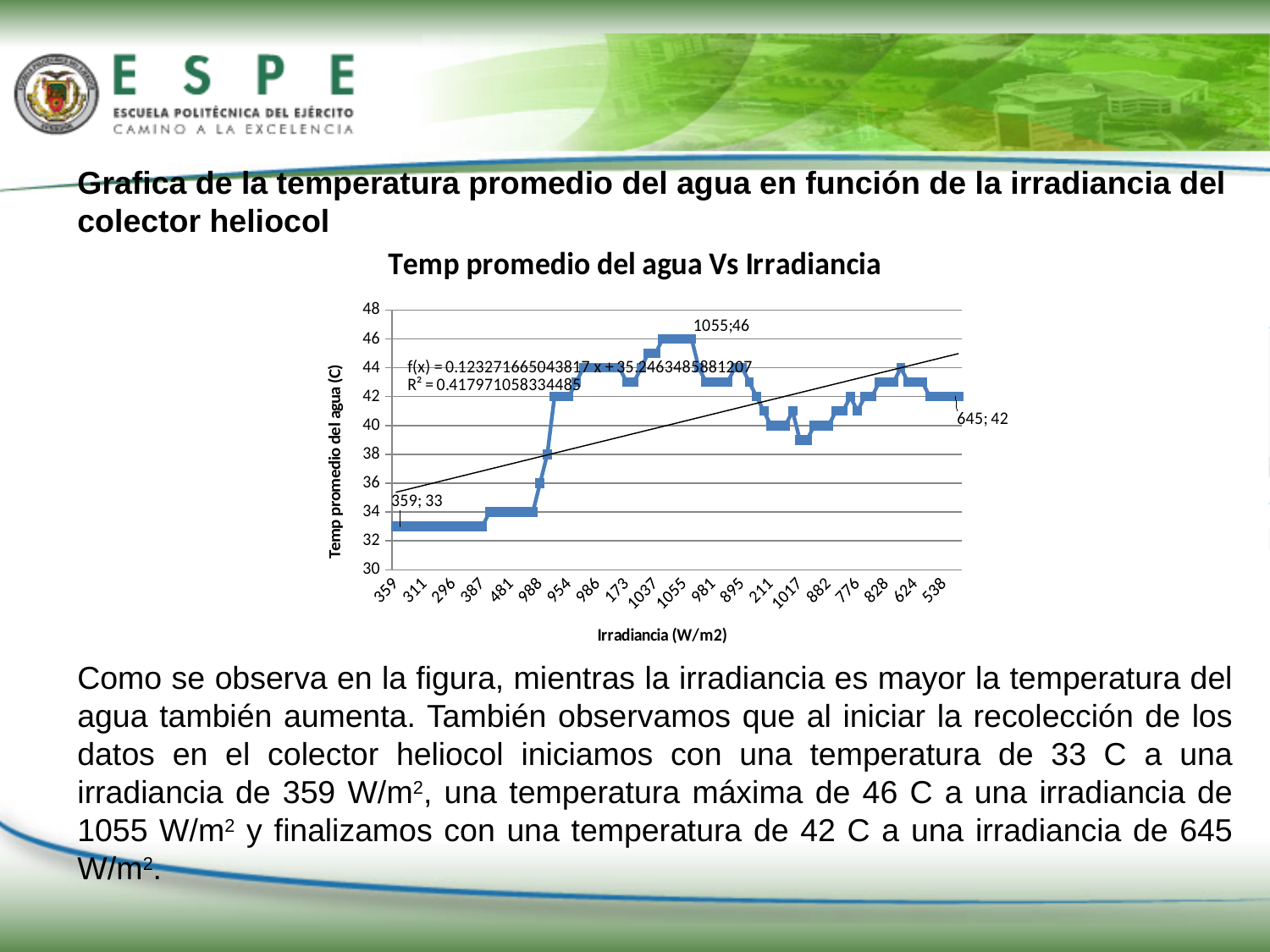
What is the title of the chart? Temp promedio del agua Vs Irradiancia Is the temperature at the x-axis label 296 greater or less than 36? less Which is larger: the labelled temperature at 645 W/m2 or at 359 W/m2? 645 W/m2 What is the difference between the labelled temperature at 1055 W/m2 and the labelled temperature at 645 W/m2? 4 What is the difference between the labelled temperature at 1055 W/m2 and the labelled temperature at 359 W/m2? 13 What is the water temperature at an irradiance of 359 W/m2, according to the data label? 33 What is the title of the vertical axis? Temp promedio del agua (C) What is the water temperature at an irradiance of 1055 W/m2, according to the data label? 46 What is the water temperature at an irradiance of 645 W/m2, according to the data label? 42 What is the highest labelled temperature value on the chart? 46 Is the temperature at the x-axis label 1037 greater or less than 40? greater What kind of chart is shown on the slide? line chart